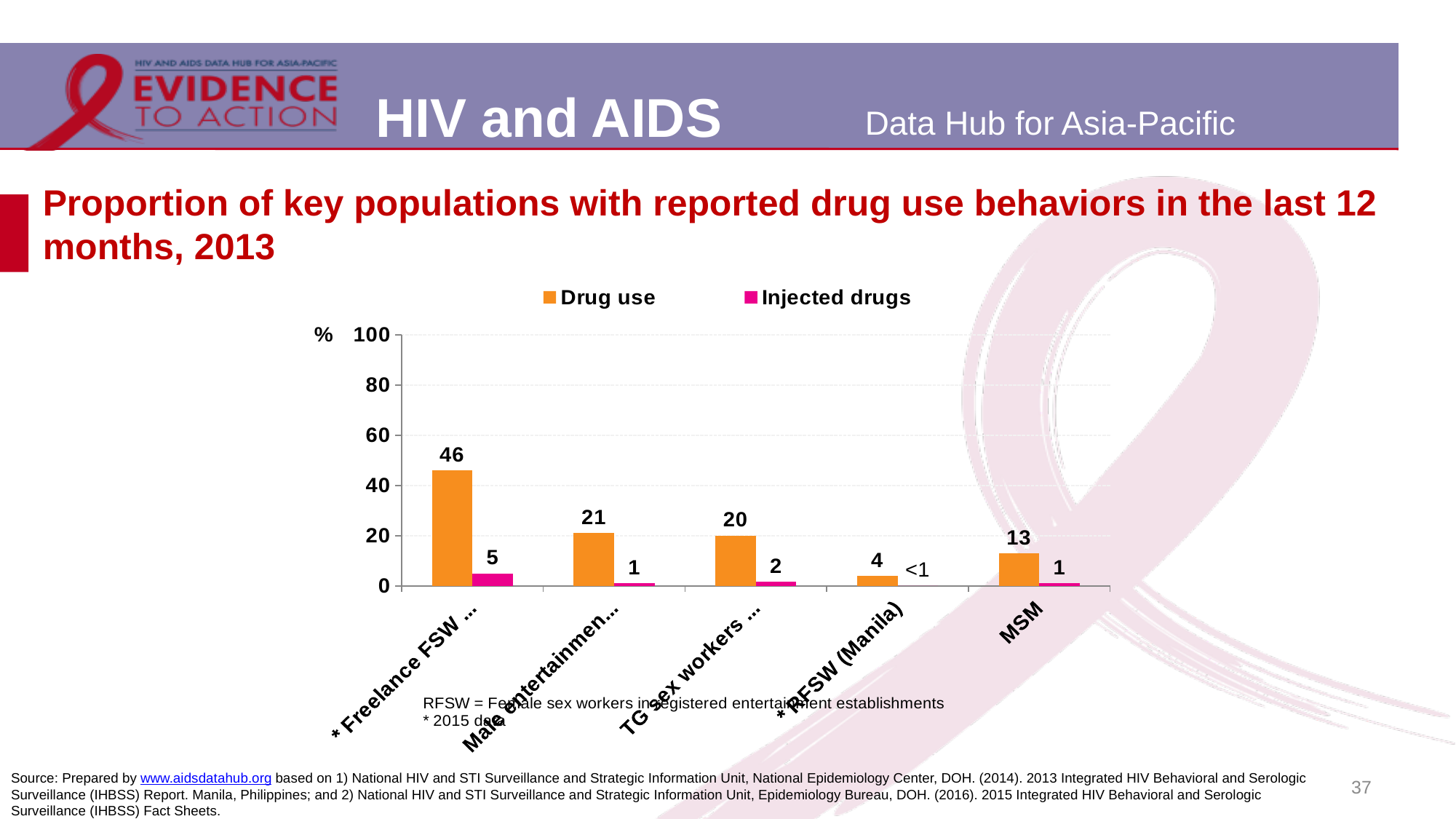
What is the difference between the Drug use value for Freelance FSW and the Drug use value for MSM? 33 Which category has the highest Drug use value? Freelance FSW What kind of chart is shown on the slide? Bar chart What is the Drug use value for MSM? 13 Which category has the lowest Drug use value? RFSW (Manila) How many series does the legend list? 2 What is the Injected drugs value for RFSW (Manila)? <1 What are the two series named in the legend? Drug use and Injected drugs Which has a larger Drug use value, MSM or RFSW (Manila)? MSM How many key population categories are plotted on the x axis? 5 What is the Drug use value for RFSW (Manila)? 4 What is the Injected drugs value for MSM? 1